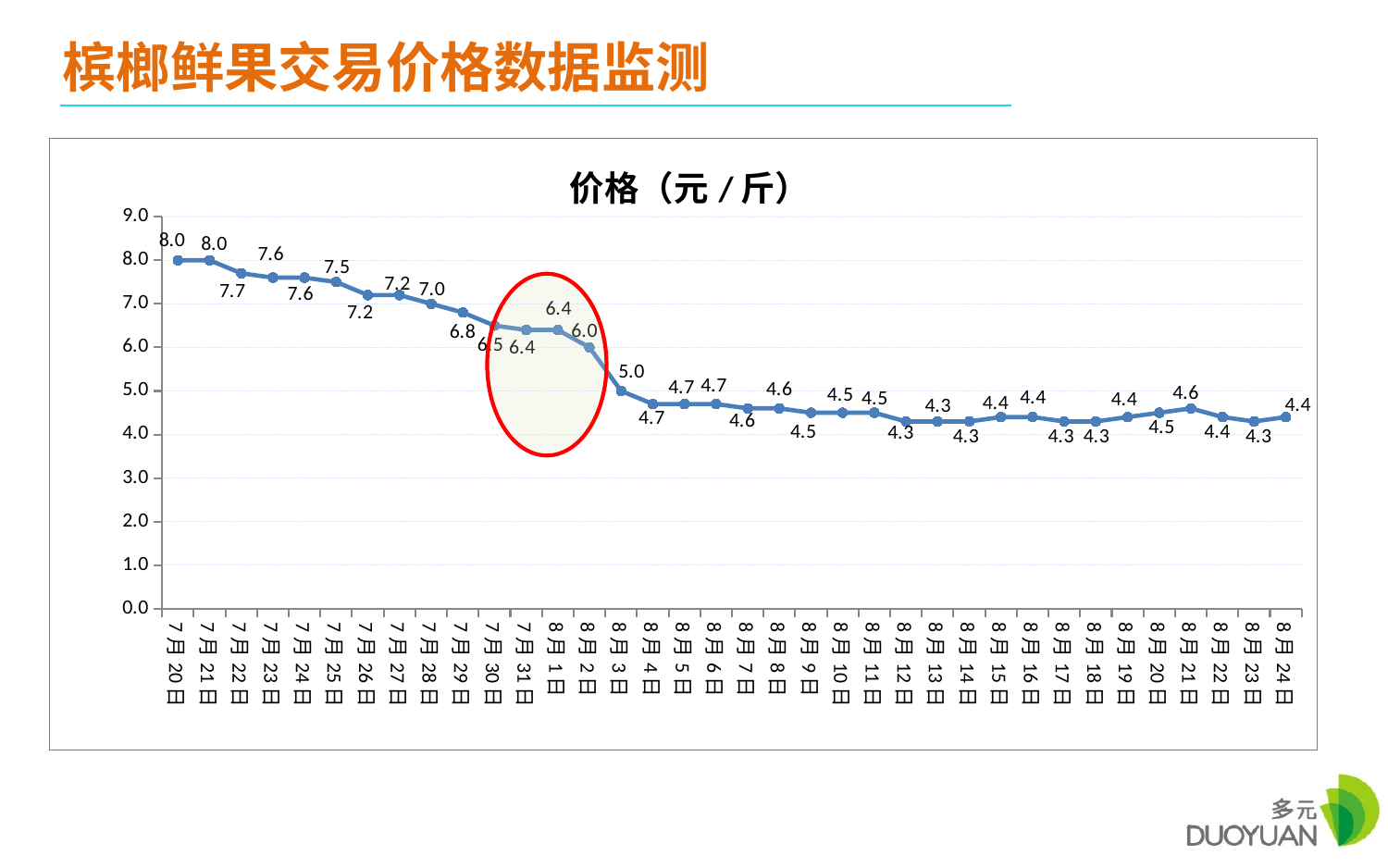
What is the price on 8月3日? 5.0 Which is higher, the price on 7月29日 or the price on 8月4日? 7月29日 What is the price on 7月20日? 8.0 What is the title of the chart? 价格（元／斤） How many data points are plotted on the chart? 36 Overall, does the price rise or fall from 7月20日 to 8月24日? fall What is the highest price value shown on the chart? 8.0 What is the price on 8月2日? 6.0 What type of chart is shown on the slide? line chart What is the difference between the price on 7月20日 and the price on 8月24日? 3.6 What is the lowest price value shown on the chart? 4.3 What is the price on 8月24日? 4.4